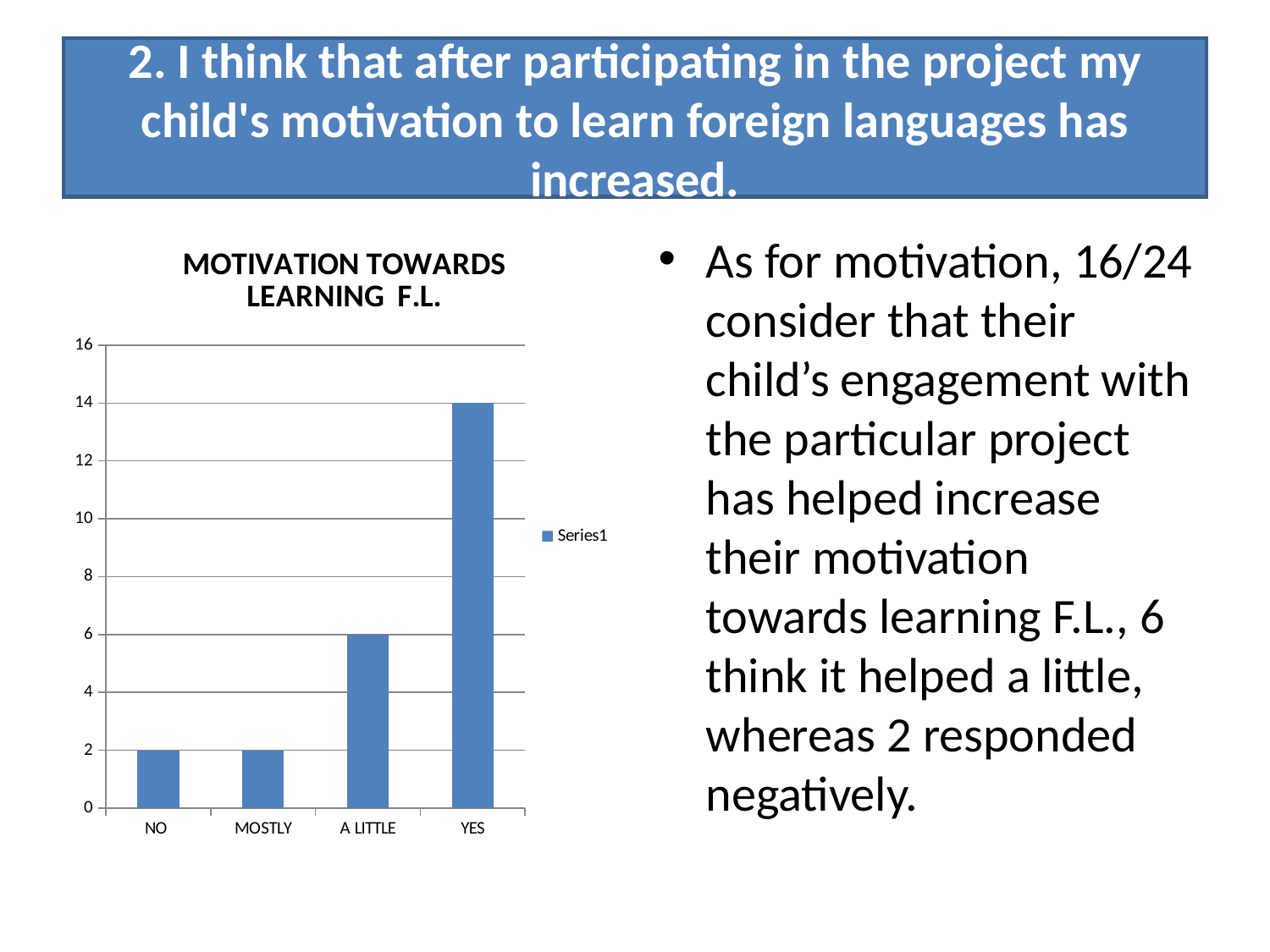
Which has a larger value, A LITTLE or MOSTLY? A LITTLE What is the value for A LITTLE in the chart? 6 Which category has the highest value in the chart? YES What is the name of the series shown in the chart legend? Series1 How many series does the chart legend list? 1 What is the difference between the values for YES and A LITTLE? 8 What is the value for YES in the chart? 14 Is the value for YES greater or less than 10? greater What is the value for NO in the chart? 2 What is the title of the chart? MOTIVATION TOWARDS LEARNING F.L. What type of chart is shown on the slide? bar chart How many categories are shown on the x axis of the chart? 4